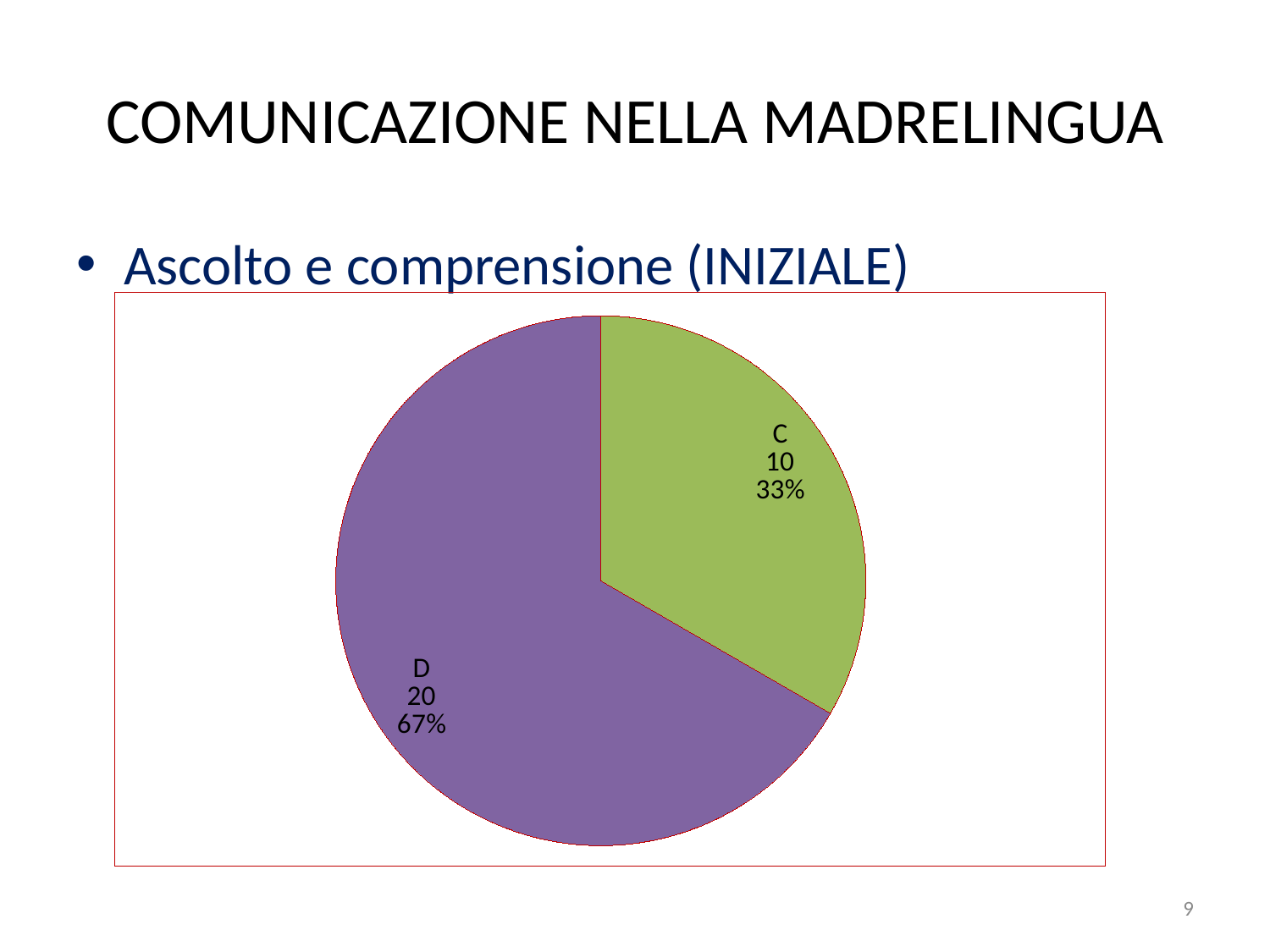
What share of the pie does slice D represent? 67% Which slice is the largest? D What share of the pie does slice C represent? 33% What is the difference between the values of D and C? 10 Which is larger, the value for C or the value for D? D What is the value for slice D? 20 What kind of chart is shown on the slide? pie chart What is the total of the values of all slices in the pie chart? 30 What is the value for slice C? 10 How many slices does the pie chart have? 2 What colour is the slice labelled D? purple Which slice is the smallest? C